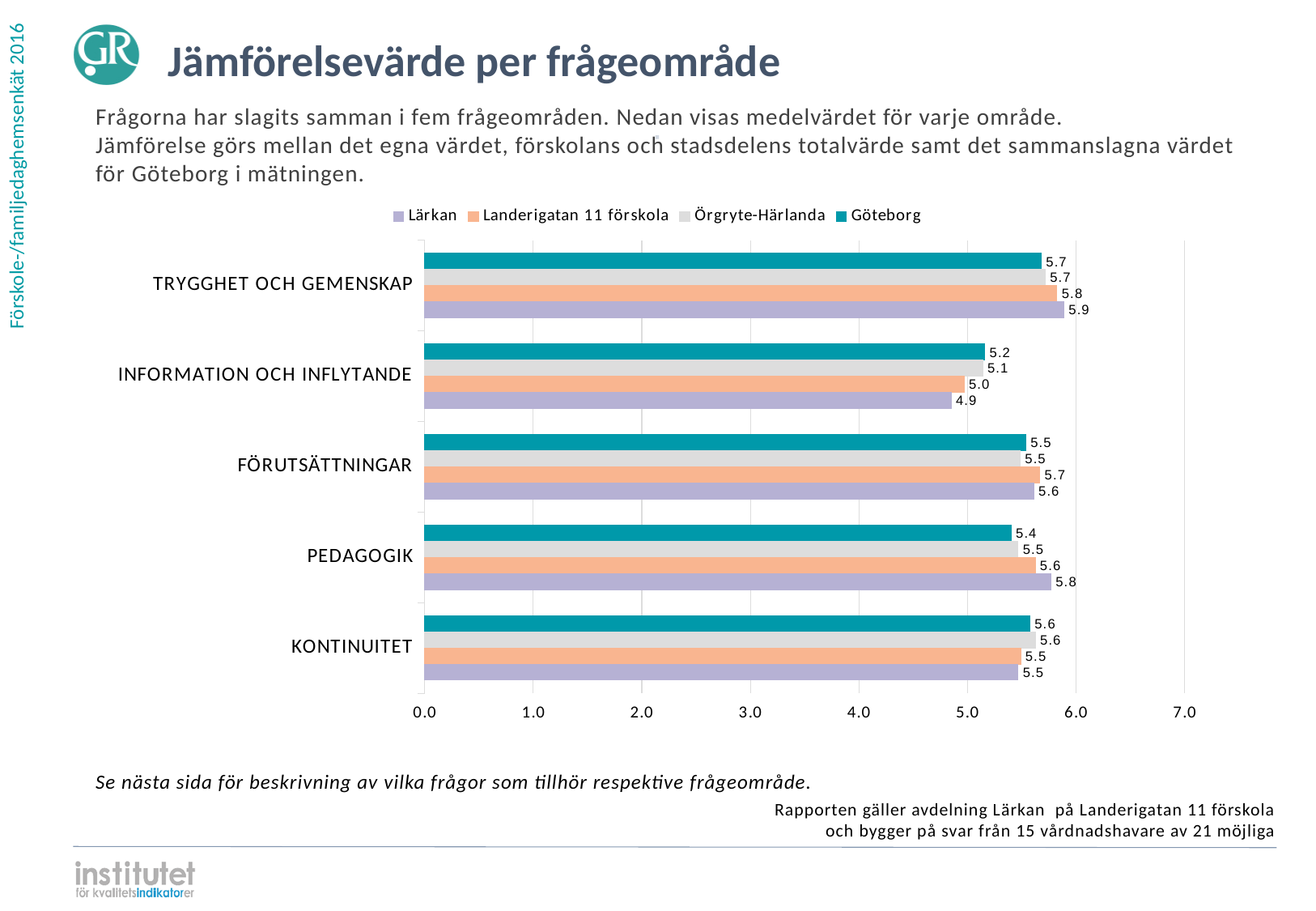
Which series is shown in teal in the legend? Göteborg What is the value for Göteborg in INFORMATION OCH INFLYTANDE? 5.2 What is the value for Örgryte-Härlanda in PEDAGOGIK? 5.5 Which is larger in INFORMATION OCH INFLYTANDE: the value for Göteborg or the value for Lärkan? Göteborg What is the value for Landerigatan 11 förskola in FÖRUTSÄTTNINGAR? 5.7 What kind of chart is shown on the slide? bar chart What is the value for Lärkan in TRYGGHET OCH GEMENSKAP? 5.9 How many question areas (categories) are shown on the chart? 5 What is the difference between the Lärkan value and the Göteborg value in PEDAGOGIK? 0.4 In which question area does Lärkan have its lowest value? INFORMATION OCH INFLYTANDE In which question area does Lärkan have its highest value? TRYGGHET OCH GEMENSKAP How many series does the legend list? 4